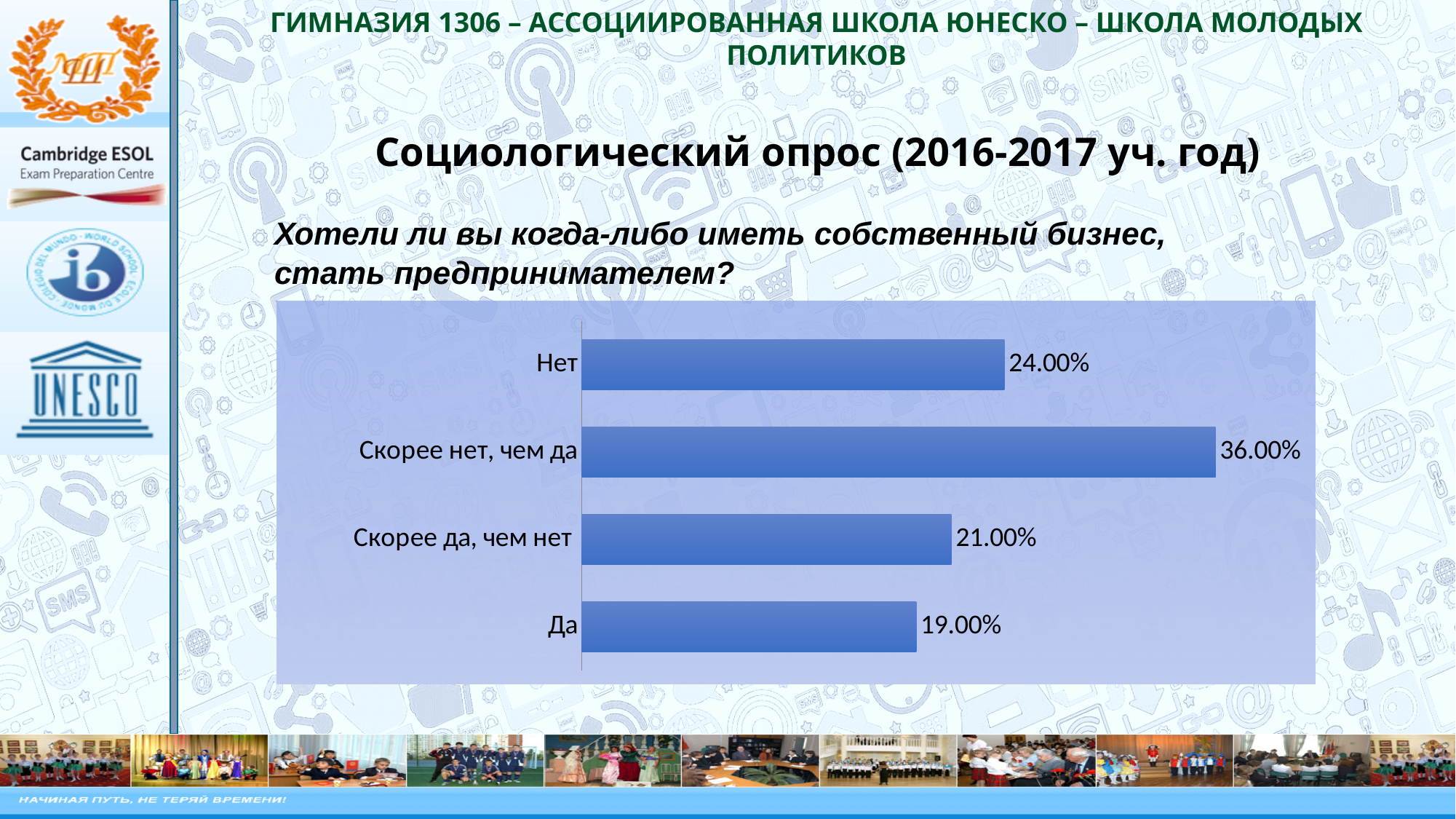
Which category has the lowest value? Да Which is larger, the value for "Нет" or the value for "Да"? Нет What is the value for "Скорее нет, чем да"? 36.00% What is the difference between the values for "Скорее нет, чем да" and "Да"? 17.00% Which category has the highest value? Скорее нет, чем да What is the difference between the values for "Нет" and "Скорее да, чем нет"? 3.00% What kind of chart is shown on the slide? Bar chart What is the value for "Нет"? 24.00% How many categories are shown in the chart? 4 What survey question does the chart answer? Хотели ли вы когда-либо иметь собственный бизнес, стать предпринимателем? What is the value for "Да"? 19.00% What is the value for "Скорее да, чем нет"? 21.00%